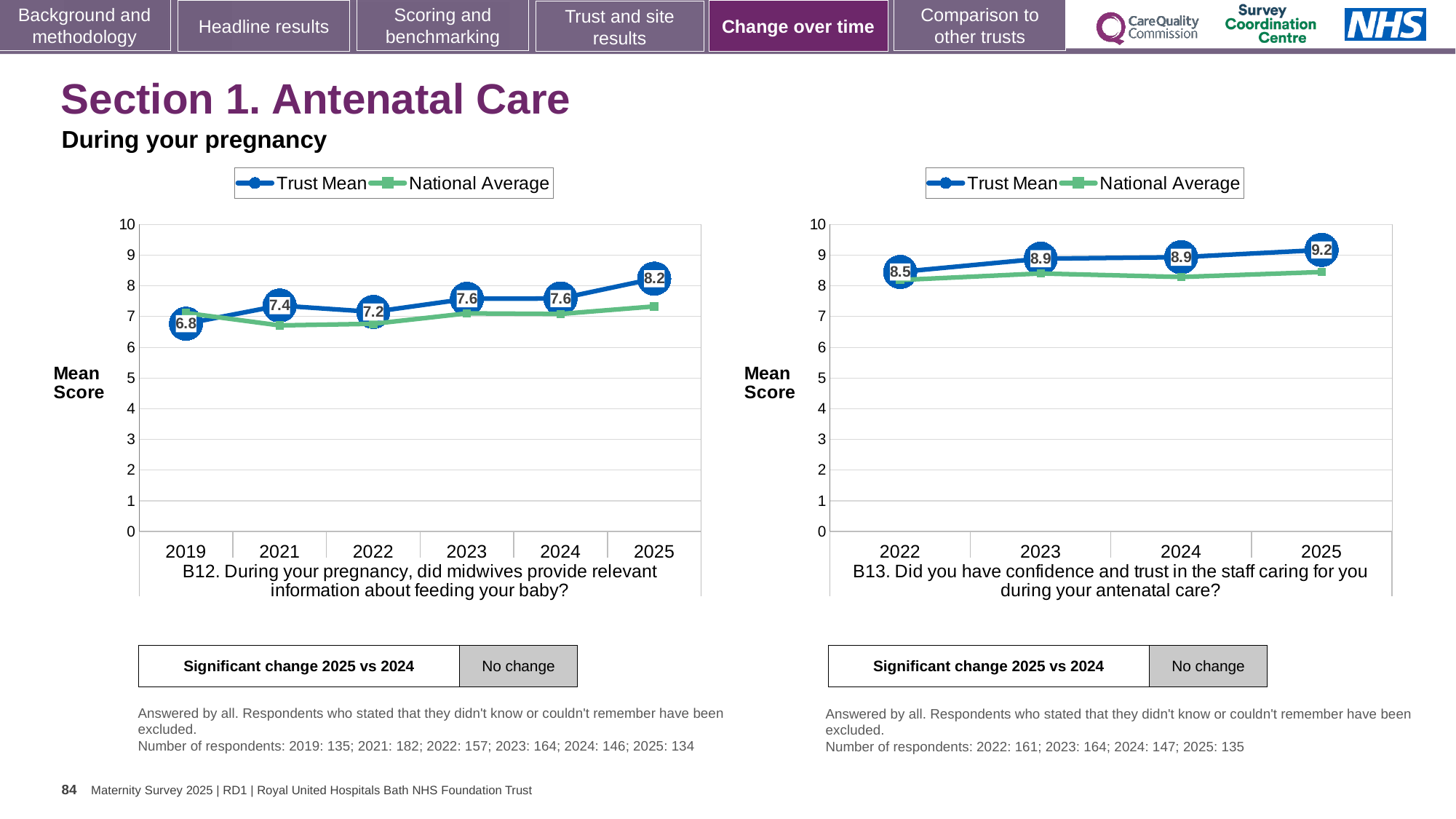
In the B13 chart (right), is the National Average for 2025 greater or less than 9? less In the B12 chart (left), which year has the lowest Trust Mean? 2019 In the B13 chart (right), what is the difference between the Trust Mean in 2025 and in 2022? 0.7 In the B13 chart (right), which year has the highest Trust Mean? 2025 How many years are plotted on the x axis of the B12 chart (left)? 6 What type of chart is the B13 chart (right)? Line chart In the B12 chart (left), what is the Trust Mean for 2025? 8.2 In the B12 chart (left), is the Trust Mean higher in 2021 or in 2022? 2021 In the B12 chart (left), what is the Trust Mean for 2019? 6.8 In the B12 chart (left), what is the difference between the Trust Mean in 2025 and in 2019? 1.4 In the B13 chart (right), what is the Trust Mean for 2022? 8.5 How many series does the legend of the B13 chart (right) list? 2